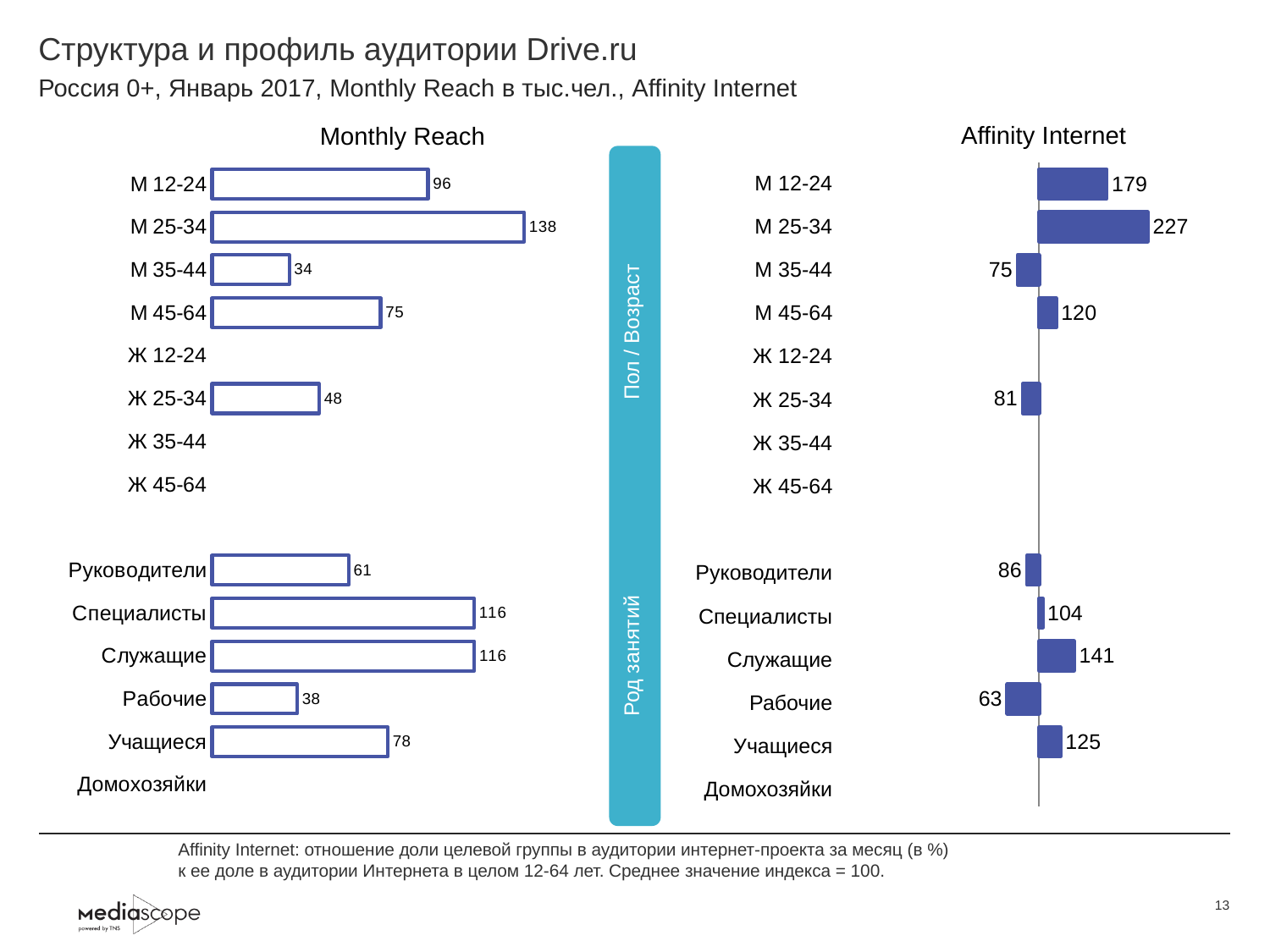
On the Monthly Reach chart, what is the value for М 25-34? 138 What kind of chart is the Monthly Reach chart? Bar chart On the Affinity Internet chart, what is the difference between the values for Учащиеся and Рабочие? 62 On the Affinity Internet chart, which is larger: the value for М 45-64 or the value for Ж 25-34? М 45-64 On the Monthly Reach chart, what is the value for Учащиеся? 78 On the Affinity Internet chart, what is the value for Служащие? 141 On the Monthly Reach chart, which category among those with a plotted bar has the lowest value? М 35-44 On the Monthly Reach chart, which is larger: the value for Руководители or the value for Рабочие? Руководители On the Monthly Reach chart, what is the difference between the values for М 25-34 and М 12-24? 42 On the Affinity Internet chart, which category has the highest value? М 25-34 On the Monthly Reach chart, what is the value for Ж 25-34? 48 On the Affinity Internet chart, which category has the lowest value? Рабочие